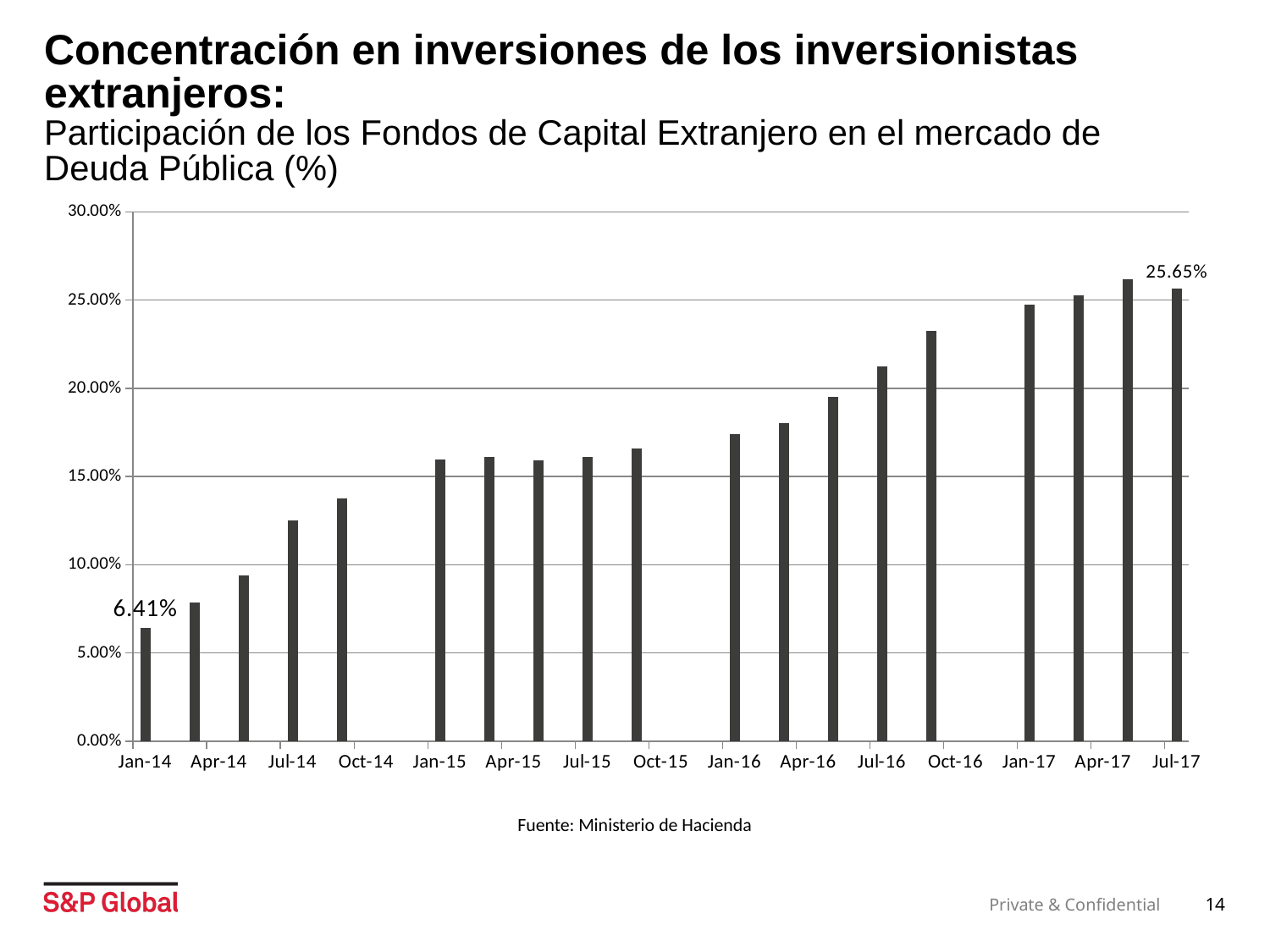
Is the value for Jan-15 greater or less than 15.00%? greater Which period has the lowest value? Jan-14 What source is cited below the chart? Ministerio de Hacienda What is the value for Jul-17? 25.65% Is the value for Jan-16 greater or less than 20.00%? less Is the value for Jul-14 greater or less than 10.00%? greater What is the difference between the Jul-17 value and the Jan-14 value? 19.24% What kind of chart is shown on the slide? bar chart Do the values generally rise or fall from Jan-14 to Jul-17? rise Which is larger, the value for Jul-17 or the value for Jan-14? Jul-17 What is the value for Jan-14? 6.41%